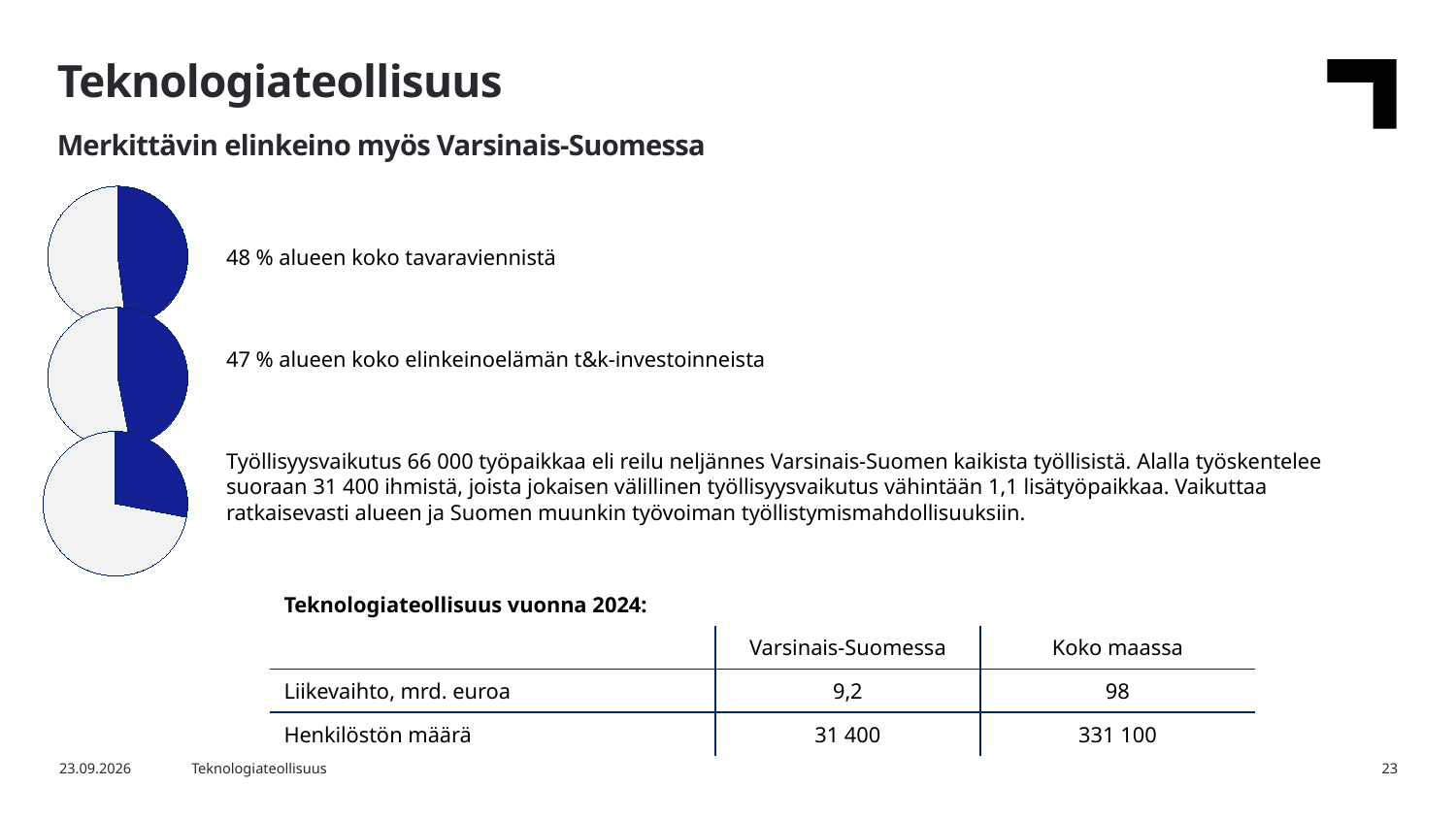
What kind of chart is used on the left side of the slide? Pie chart In the top pie chart, what share of the region's total goods exports (tavaravienti) does the blue slice represent? 48 % Is the blue slice larger in the top pie chart or in the bottom pie chart? The top pie chart Is the blue slice of the bottom pie chart greater or less than half of the pie? less Is the blue slice of the top pie chart greater or less than a quarter of the pie? greater Which of the three pie charts has the smallest blue slice? The bottom pie chart How many pie charts are shown on the slide? 3 In the middle pie chart, what share of the region's business R&D investments (t&k-investoinnit) does the blue slice represent? 47 % What does the bottom pie chart illustrate, according to the text next to it? Employment impact: 66 000 jobs, over a quarter of all employed in Varsinais-Suomi What colour is the highlighted slice in the pie charts? Blue How many slices does each pie chart have? 2